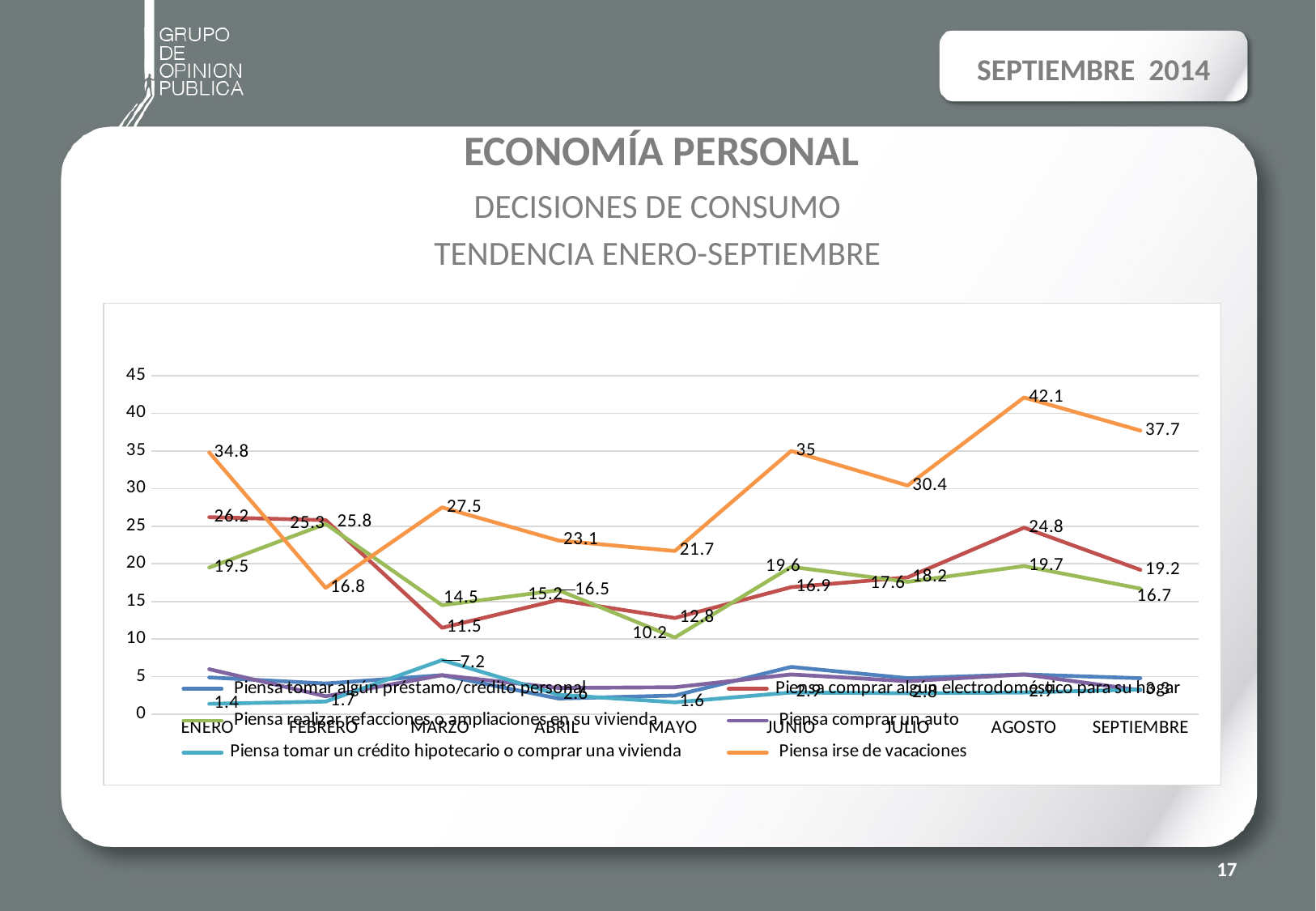
Does the 'Piensa comprar algún electrodoméstico para su hogar' line rise or fall from MAYO to AGOSTO? rise How many months are shown on the x axis? 9 What is the value for 'Piensa comprar algún electrodoméstico para su hogar' in MARZO? 11.5 In which month does 'Piensa irse de vacaciones' reach its highest value? AGOSTO What kind of chart is shown on the slide? line chart What is the difference between the 'Piensa irse de vacaciones' values in AGOSTO and SEPTIEMBRE? 4.4 In which month does 'Piensa irse de vacaciones' have its lowest value? FEBRERO Is the value for 'Piensa irse de vacaciones' in JUNIO greater or less than 30? greater What is the value for 'Piensa realizar refacciones o ampliaciones en su vivienda' in MAYO? 10.2 In MARZO, which is larger: 'Piensa comprar algún electrodoméstico para su hogar' or 'Piensa realizar refacciones o ampliaciones en su vivienda'? Piensa realizar refacciones o ampliaciones en su vivienda How many series does the legend list? 6 What is the value for 'Piensa irse de vacaciones' in AGOSTO? 42.1